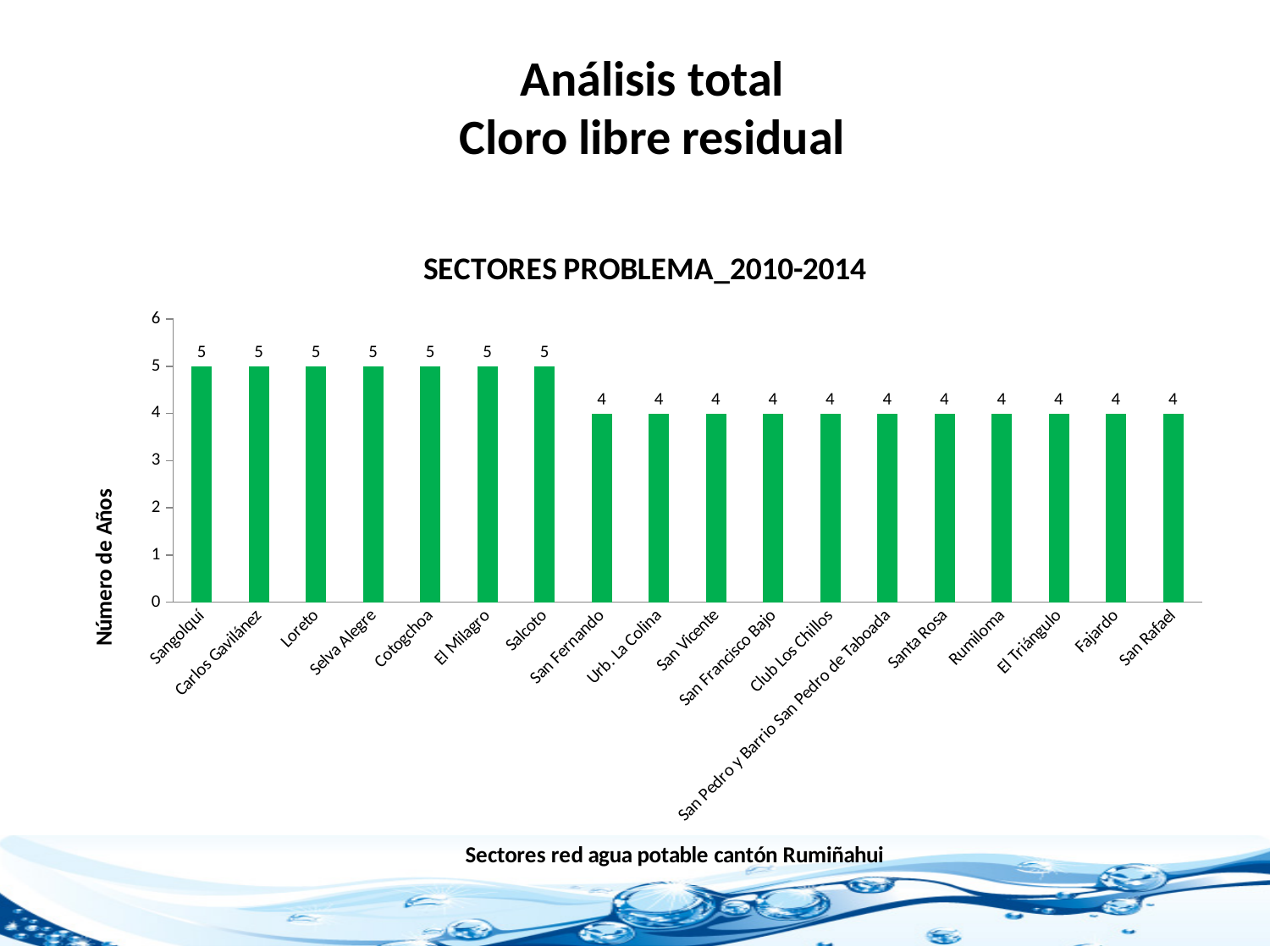
Which has a larger value, Rumiloma or El Milagro? El Milagro Which has a larger value, Cotogchoa or Santa Rosa? Cotogchoa How many categories have a value of 5? 7 What kind of chart is shown? Bar chart What is the value for San Fernando? 4 What is the value for Salcoto? 5 What is the difference between the values for Loreto and Fajardo? 1 What is the label of the vertical axis? Número de Años What is the value for San Pedro y Barrio San Pedro de Taboada? 4 What is the title of the chart? SECTORES PROBLEMA_2010-2014 What is the value for Sangolquí? 5 How many categories are shown on the x axis? 18